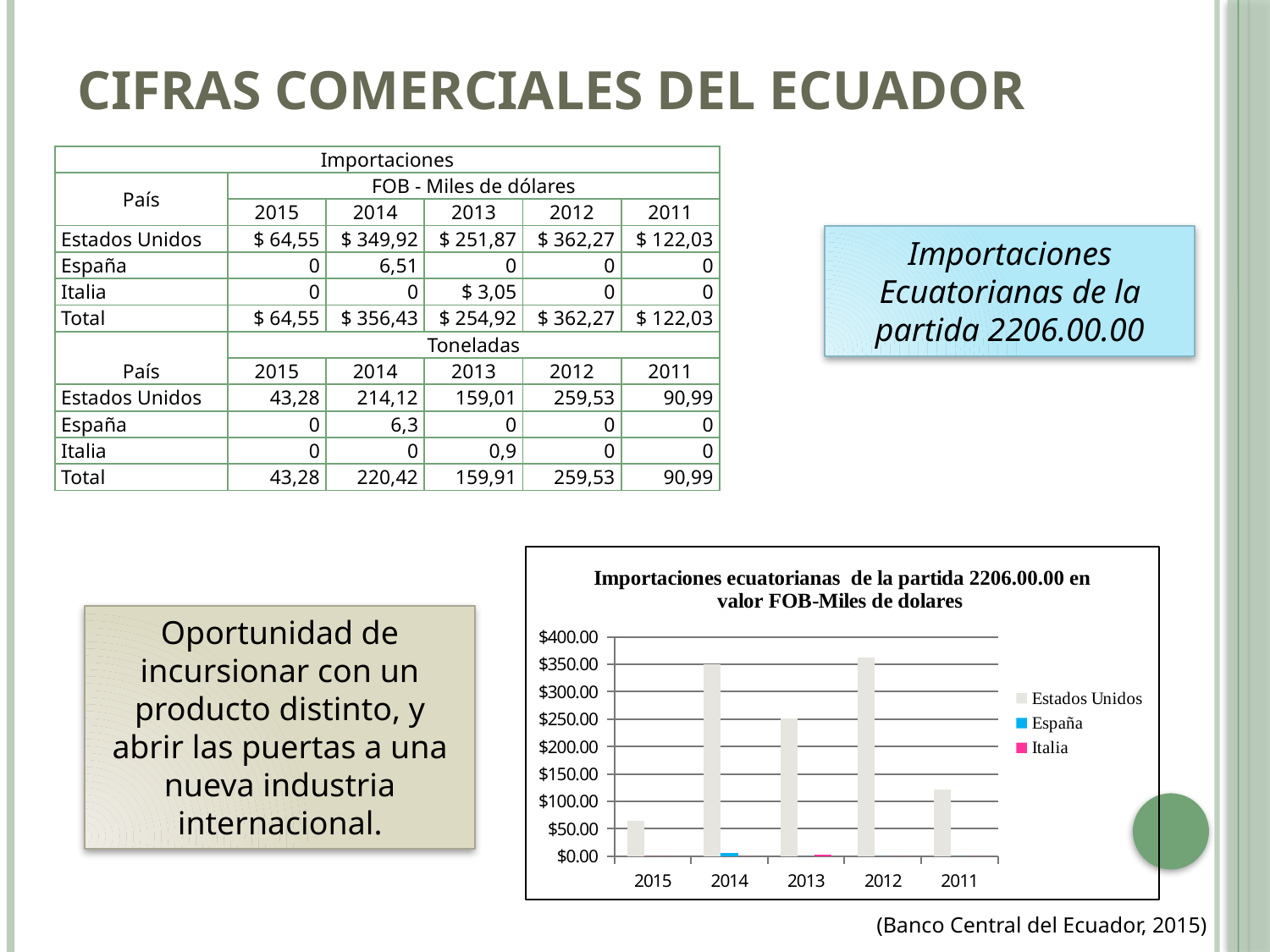
What colour represents España in the chart's legend? blue How many series does the chart's legend list? 3 How many years are shown along the x axis of the chart? 5 In which year does the Estados Unidos bar reach its highest value in the chart? 2012 In the chart, is the value for Estados Unidos in 2014 greater or less than $300.00? greater What is the title of the chart? Importaciones ecuatorianas de la partida 2206.00.00 en valor FOB-Miles de dolares In the chart, is the value for Estados Unidos in 2015 greater or less than $100.00? less In which year does the Estados Unidos bar reach its lowest value in the chart? 2015 In the chart, is the value for Estados Unidos in 2011 greater or less than $100.00? greater What kind of chart is shown on the slide? bar chart In the chart, which year has the larger Estados Unidos value, 2013 or 2011? 2013